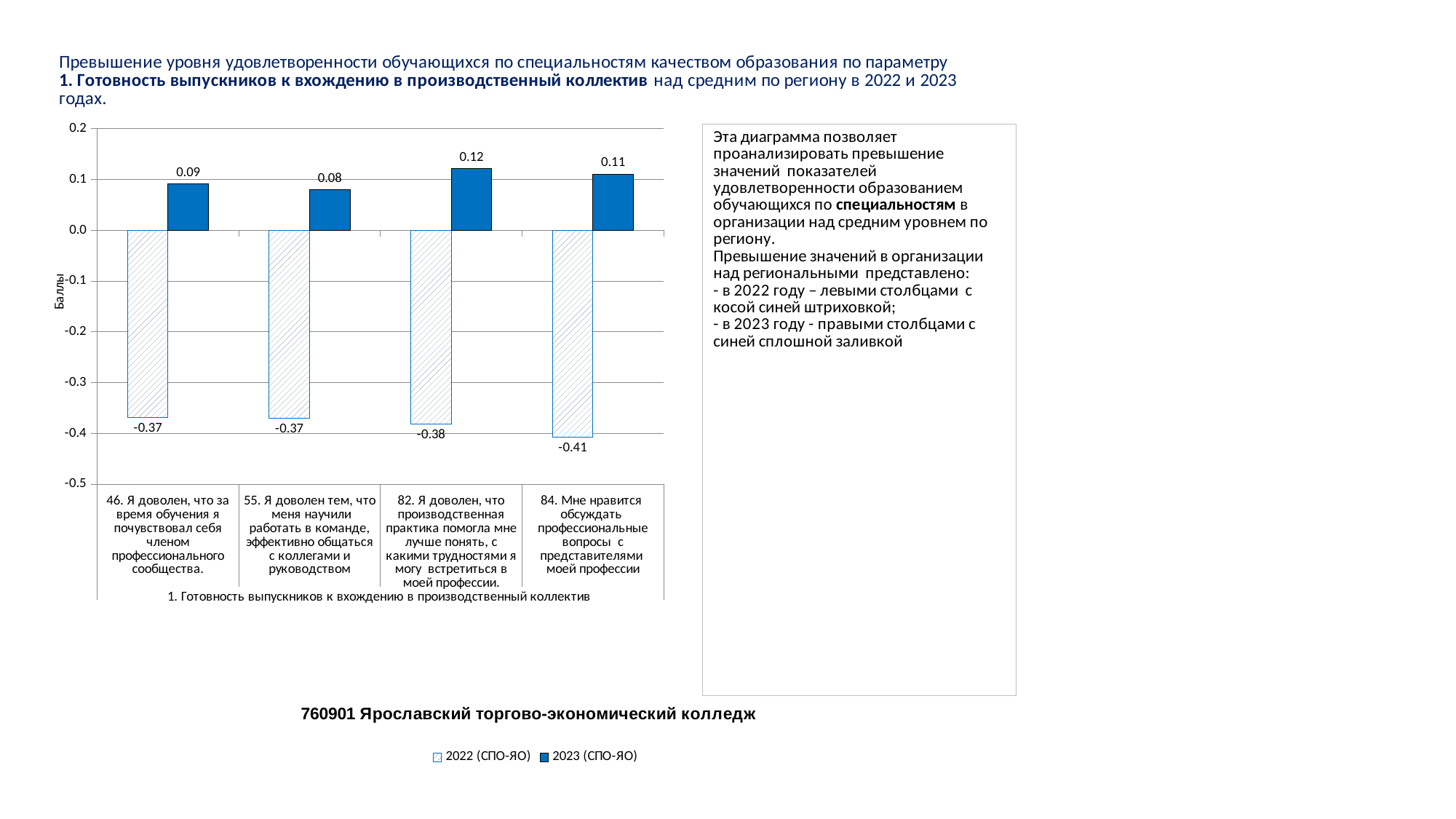
Which series is shown with diagonal blue hatching? 2022 (СПО-ЯО) How many series does the legend list? 2 How many categories (questions) are shown on the x axis? 4 What is the 2023 (СПО-ЯО) value for question 55 ("Я доволен тем, что меня научили работать в команде...")? 0.08 What is the label of the y axis? Баллы What is the difference between the 2023 and 2022 values for question 82? 0.5 Which category has the lowest 2022 (СПО-ЯО) value? 84. Мне нравится обсуждать профессиональные вопросы с представителями моей профессии What type of chart is shown on the slide? bar chart Which is larger: the 2023 value for question 46 or the 2023 value for question 55? question 46 What is the 2023 (СПО-ЯО) value for question 46 ("Я доволен, что за время обучения я почувствовал себя членом профессионального сообщества")? 0.09 Which category has the highest 2023 (СПО-ЯО) value? 82. Я доволен, что производственная практика помогла мне лучше понять, с какими трудностями я могу встретиться в моей профессии. What is the 2022 (СПО-ЯО) value for question 84 ("Мне нравится обсуждать профессиональные вопросы с представителями моей профессии")? -0.41